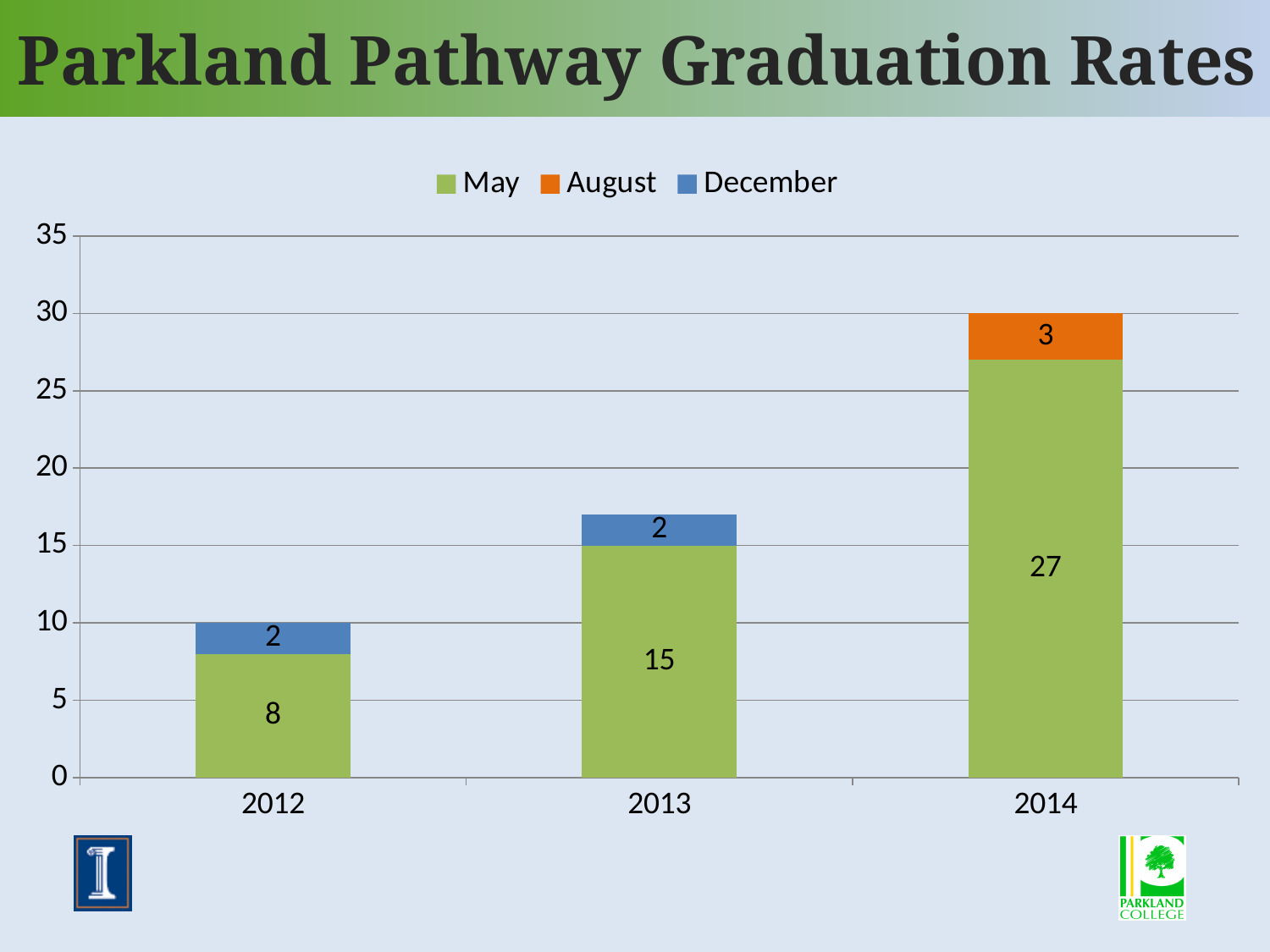
How many series does the legend list? 3 Is the May value for 2013 larger than the May value for 2012? Yes What is the total of the stacked bar for 2012? 10 What is the May value for 2013? 15 What is the total of the stacked bar for 2014? 30 What is the May value for 2014? 27 Which year has the highest May value? 2014 Which year has the lowest May value? 2012 What is the difference between the May values for 2014 and 2013? 12 What is the August value for 2014? 3 What is the December value for 2012? 2 What kind of chart is shown on the slide? Stacked bar chart